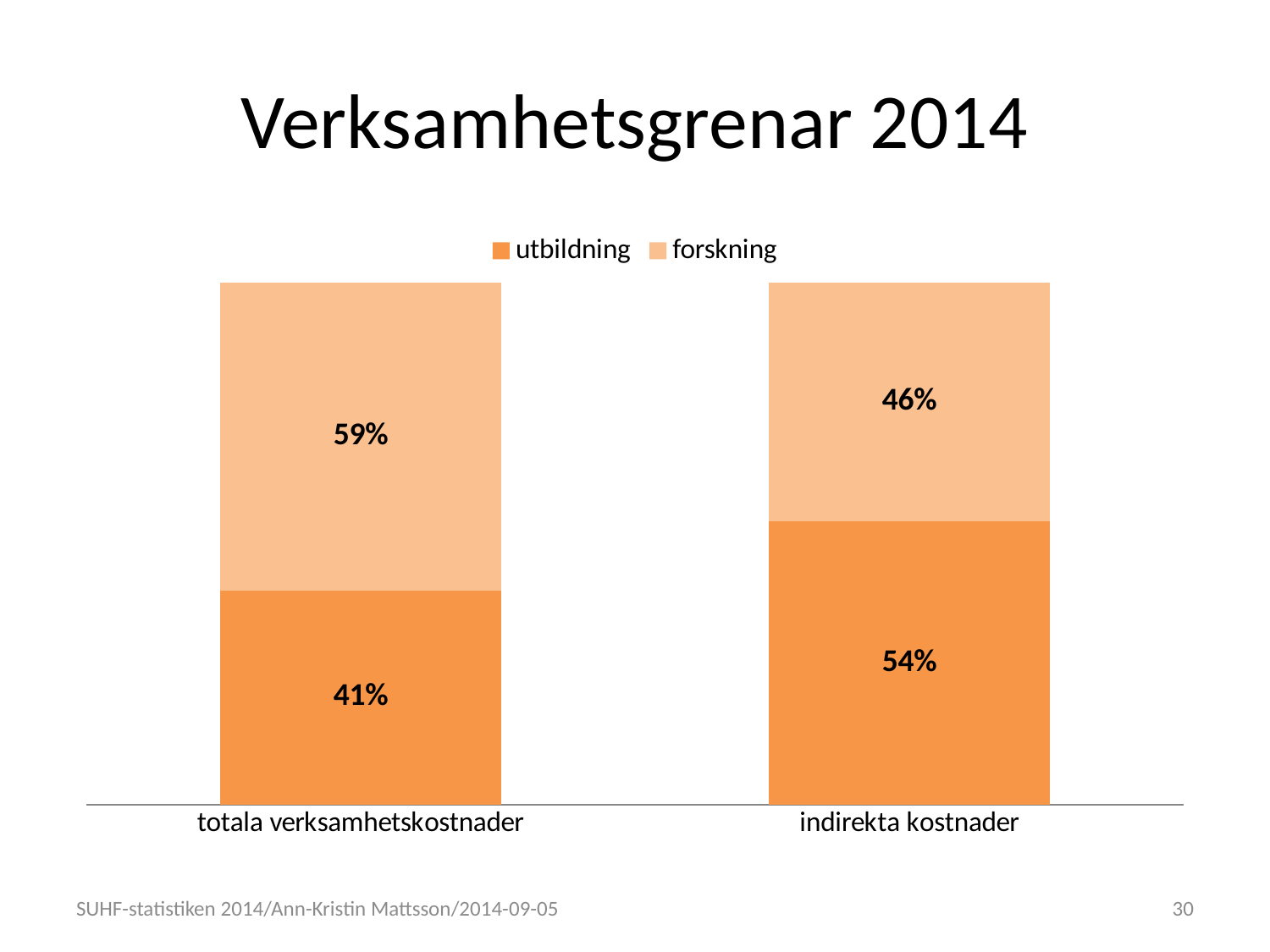
Which category has the higher value for utbildning? indirekta kostnader What is the value for forskning in the totala verksamhetskostnader bar? 59% How many series does the legend list? 2 How many categories are shown on the x axis? 2 What is the value for utbildning in the totala verksamhetskostnader bar? 41% What is the value for forskning in the indirekta kostnader bar? 46% What is the difference between the forskning and utbildning values for totala verksamhetskostnader? 18% What is the total of the stacked bar for indirekta kostnader? 100% What is the difference between the utbildning and forskning values for indirekta kostnader? 8% Which category has the higher value for forskning? totala verksamhetskostnader What is the value for utbildning in the indirekta kostnader bar? 54% What kind of chart is shown on the slide? stacked bar chart